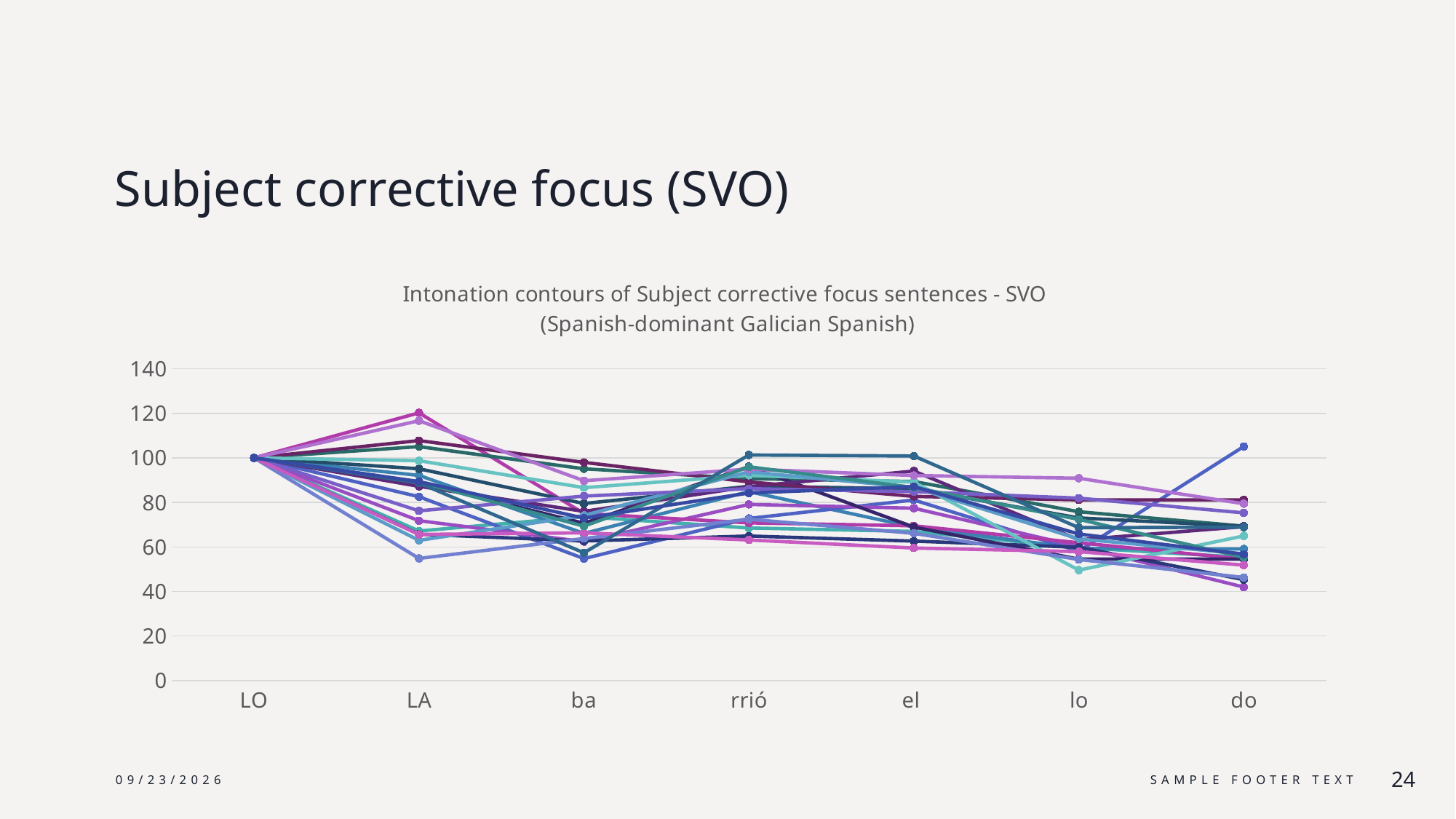
At which x-axis category does the chart reach its highest value? LA Is the lowest value at do greater or less than 50? less Is the lowest value at lo greater or less than 60? less At which x-axis category does the chart reach its lowest value? do Overall, do the lines rise or fall from LO to do? fall What is the first line of the chart's title? Intonation contours of Subject corrective focus sentences - SVO Is the highest value at lo greater or less than 100? less What value do all the lines share at the category LO? 100 What is the label of the last category on the x axis? do How many categories are shown on the x axis of the chart? 7 What kind of chart is shown on the slide? line chart